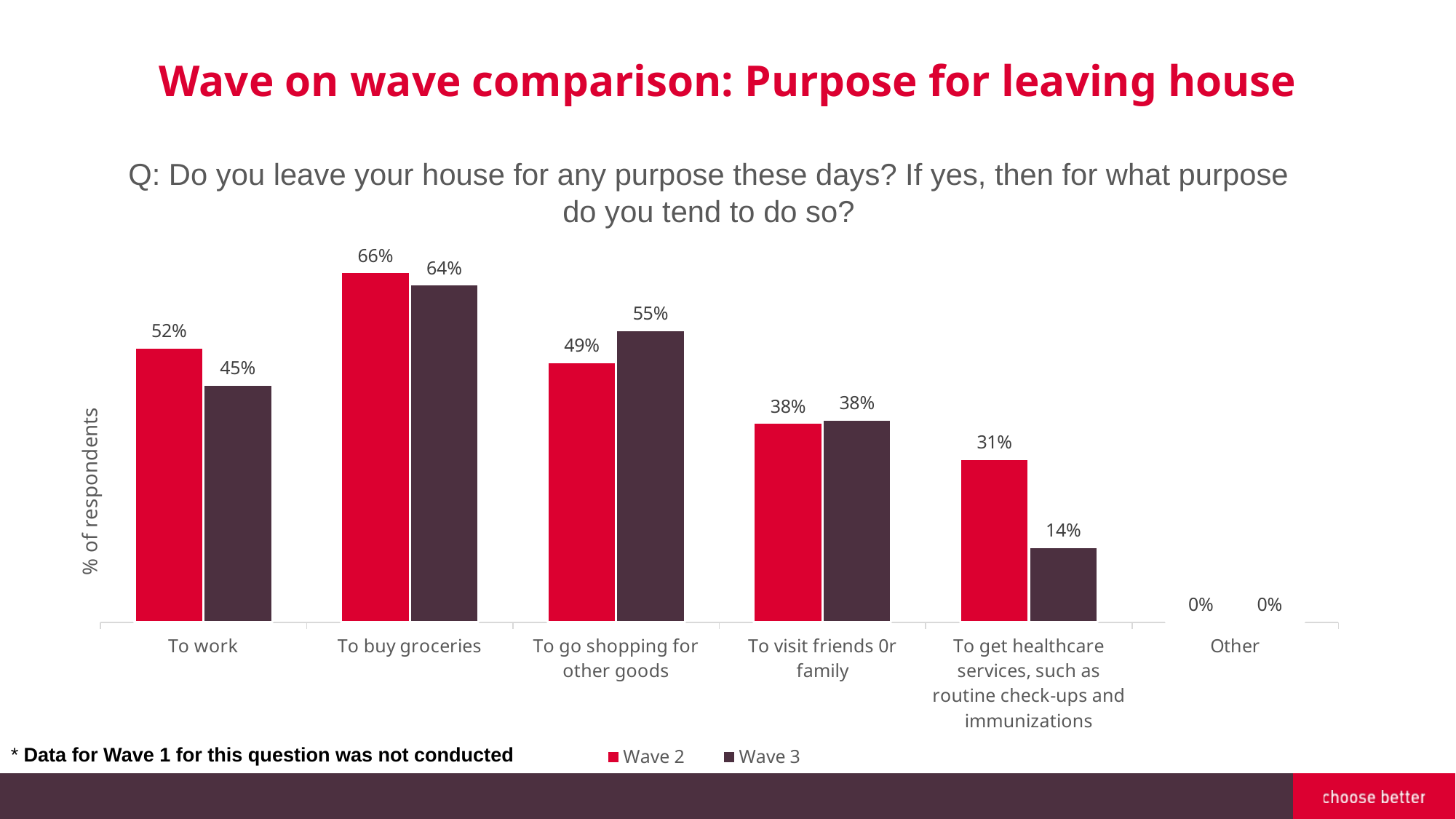
For 'To go shopping for other goods', which is larger: the Wave 2 value or the Wave 3 value? Wave 3 How many categories are shown on the x axis? 6 How many series does the legend list? 2 What is the Wave 3 value for 'To get healthcare services, such as routine check-ups and immunizations'? 14% What kind of chart is shown on the slide? Bar chart Which category has the lowest Wave 3 value? Other What is the difference between the Wave 2 and Wave 3 values for 'To work'? 7% What is the Wave 2 value for 'To work'? 52% What is the label of the y axis? % of respondents What is the Wave 3 value for 'To go shopping for other goods'? 55% Which category has the highest Wave 2 value? To buy groceries What is the difference between the Wave 2 and Wave 3 values for 'To get healthcare services, such as routine check-ups and immunizations'? 17%